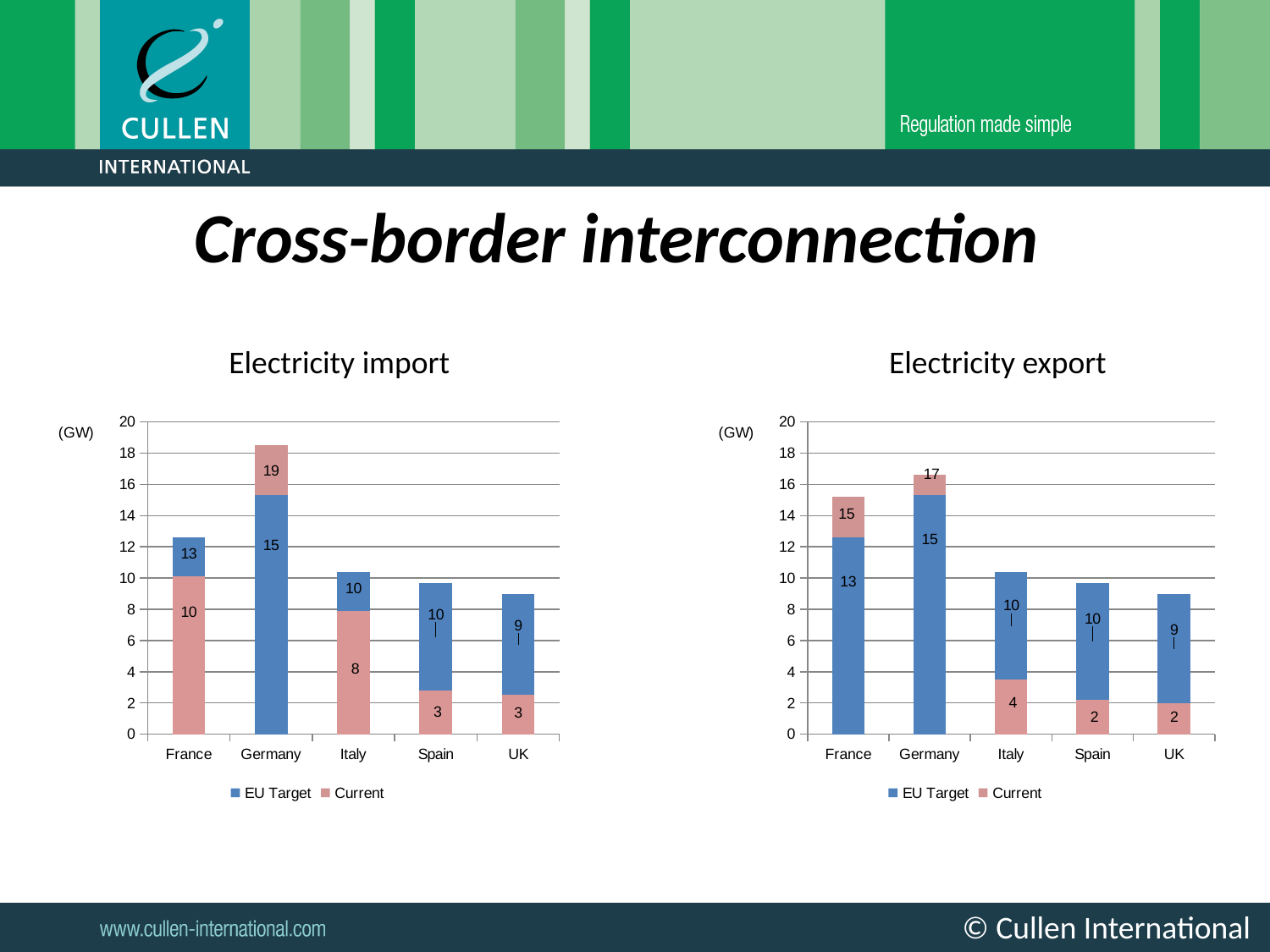
In the Electricity import chart, what is the Current value for Germany? 19 How many series does the legend of the Electricity import chart list? 2 How many countries are shown on the x axis of the Electricity export chart? 5 What type of chart is the Electricity export chart? Bar chart In the Electricity import chart, what is the EU Target value for France? 13 In the Electricity import chart, is the Current value for Italy greater or less than 10? less In the Electricity export chart, which is larger for France: the EU Target value or the Current value? Current In the Electricity export chart, which country has the lowest EU Target value? UK In the Electricity export chart, what is the Current value for Italy? 4 In the Electricity import chart, what is the difference between the Current value and the EU Target value for Spain? 7 In the Electricity import chart, which country has the highest Current value? Germany In the Electricity export chart, what is the EU Target value for the UK? 9